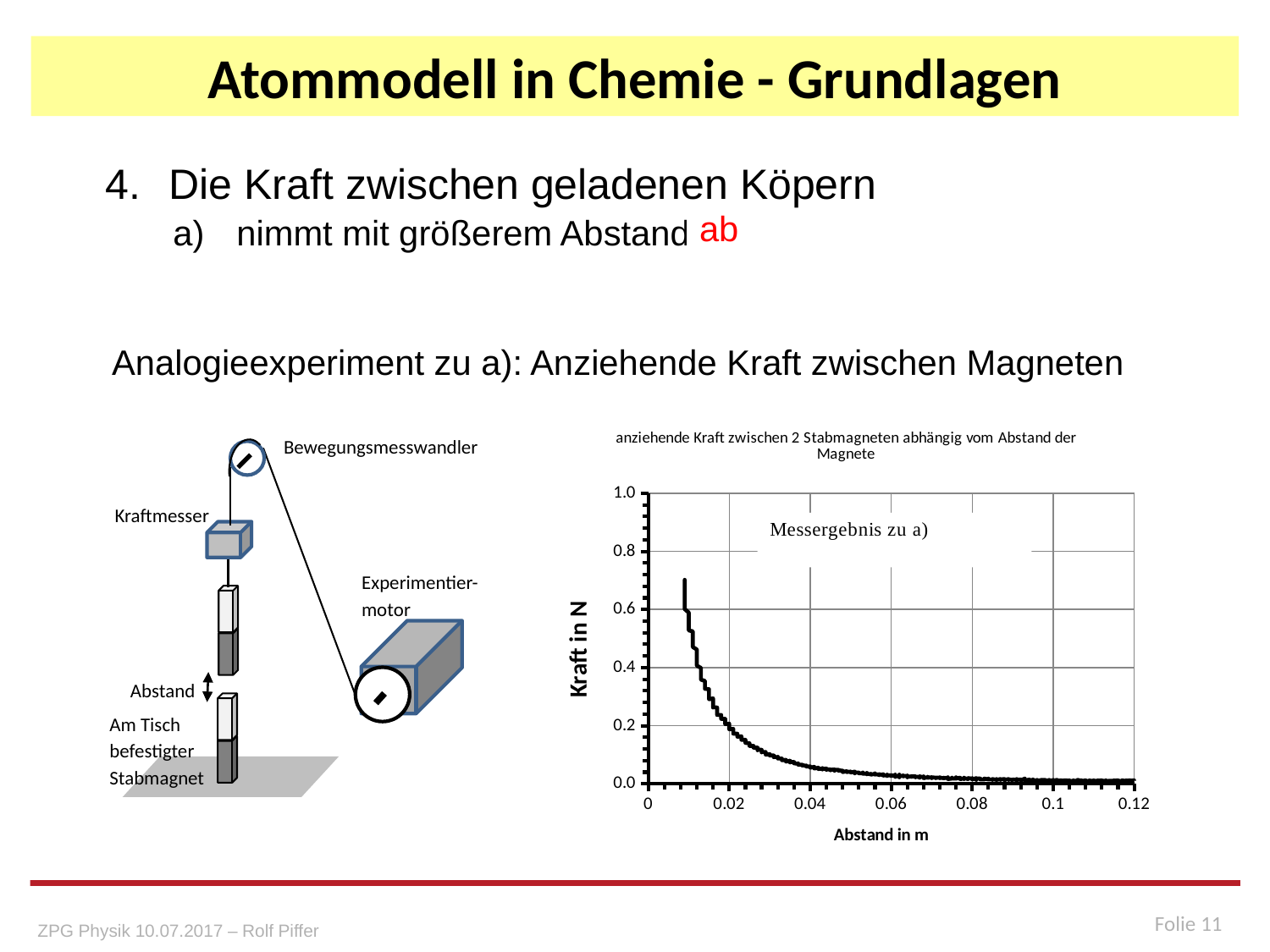
What is the maximum value shown on the y axis of the chart? 1.0 Is the force at a distance of 0.02 m greater or less than 0.4 N? less What is the title of the chart? anziehende Kraft zwischen 2 Stabmagneten abhängig vom Abstand der Magnete What kind of chart is shown on the slide? scatter chart What is the maximum value shown on the x axis of the chart? 0.12 Is the force at a distance of 0.04 m greater or less than 0.2 N? less What is the label of the vertical axis of the chart? Kraft in N Is the highest force value plotted on the chart greater or less than 0.6 N? greater As the distance (Abstand) increases along the x axis, does the force rise or fall? fall Is the force larger at a distance of 0.02 m or at a distance of 0.06 m? 0.02 m